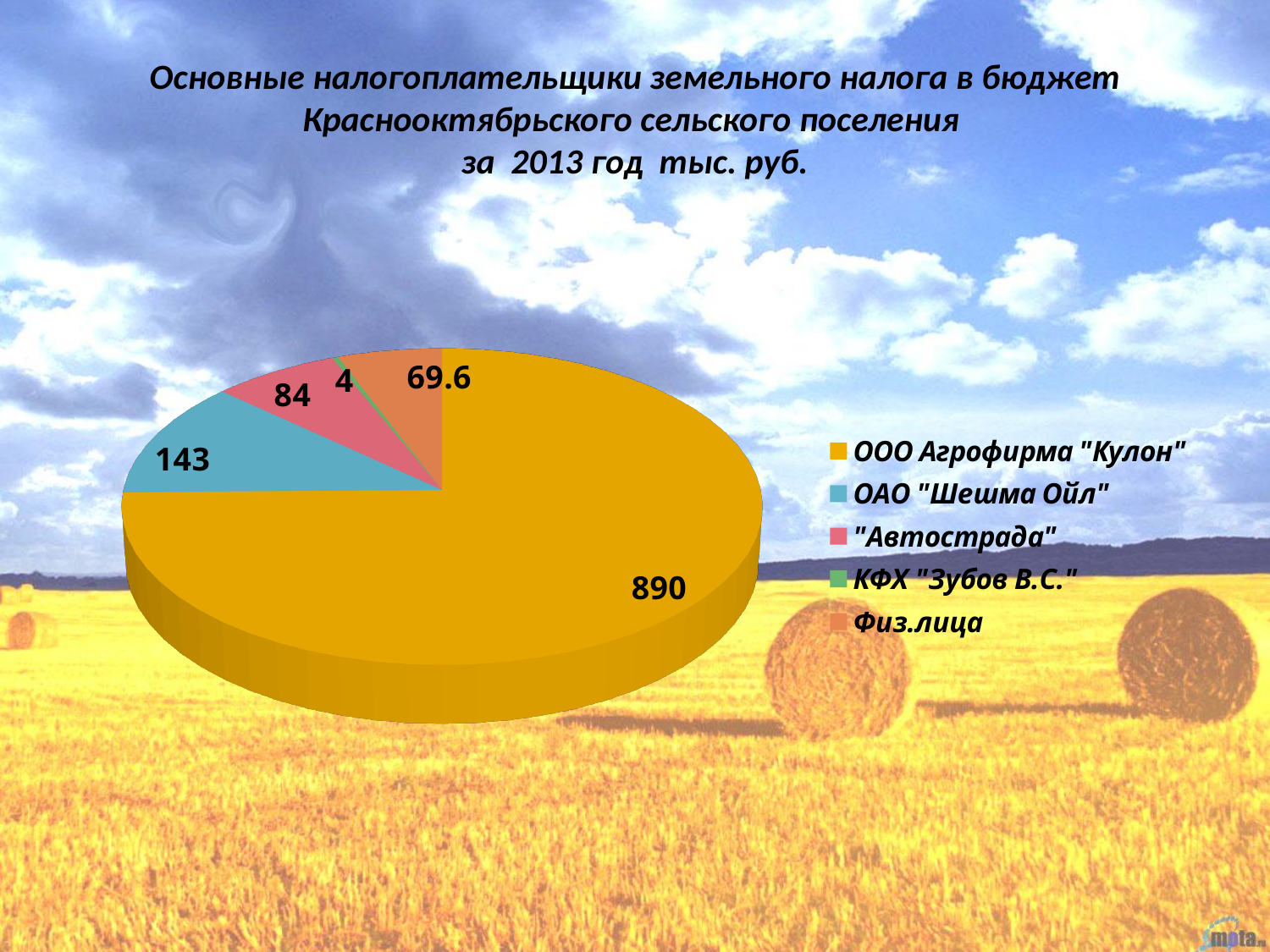
What is the value for Физ.лица? 69.6 How many categories does the legend list? 5 Which taxpayer has the smallest slice of the pie? КФХ "Зубов В.С." What is the value for ОАО "Шешма Ойл"? 143 Which taxpayer has the largest slice of the pie? ООО Агрофирма "Кулон" What colour is the slice for ОАО "Шешма Ойл"? Blue What is the value for ООО Агрофирма "Кулон"? 890 What is the value for "Автострада"? 84 What is the value for КФХ "Зубов В.С."? 4 What is the difference between the values for ООО Агрофирма "Кулон" and ОАО "Шешма Ойл"? 747 Which is larger, the value for "Автострада" or the value for Физ.лица? "Автострада" What type of chart is shown on the slide? Pie chart